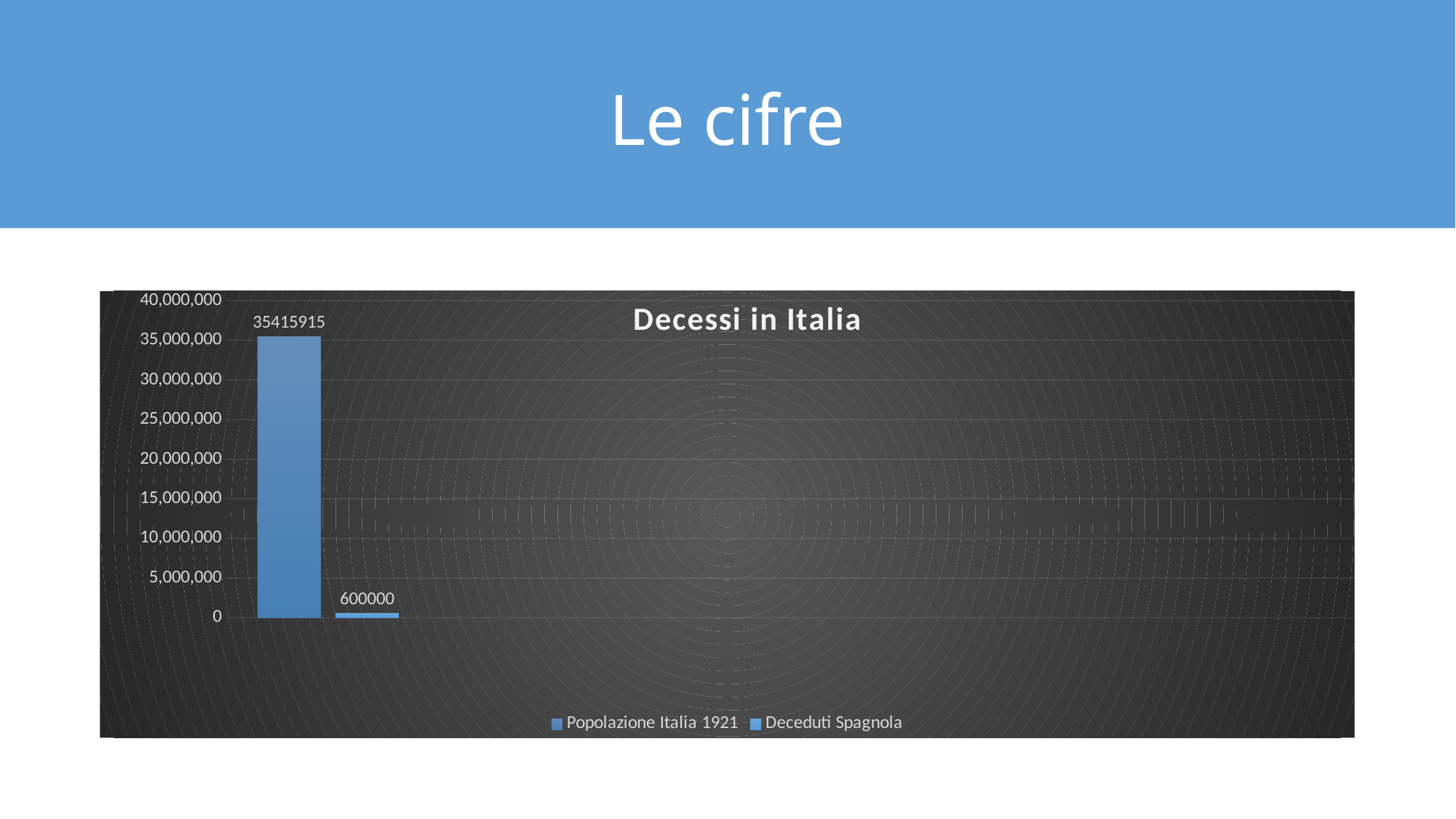
Is the value for Popolazione Italia 1921 greater or less than 30,000,000? greater What is the highest value shown on the vertical axis? 40,000,000 Is the value for Deceduti Spagnola greater or less than 5,000,000? less What is the title of the chart? Decessi in Italia How many series does the legend list? 2 Which is larger, Popolazione Italia 1921 or Deceduti Spagnola? Popolazione Italia 1921 Which series has the highest value? Popolazione Italia 1921 Which series has the lowest value? Deceduti Spagnola What is the value for Deceduti Spagnola? 600000 What is the difference between Popolazione Italia 1921 and Deceduti Spagnola? 34815915 What kind of chart is shown? bar chart What is the value for Popolazione Italia 1921? 35415915